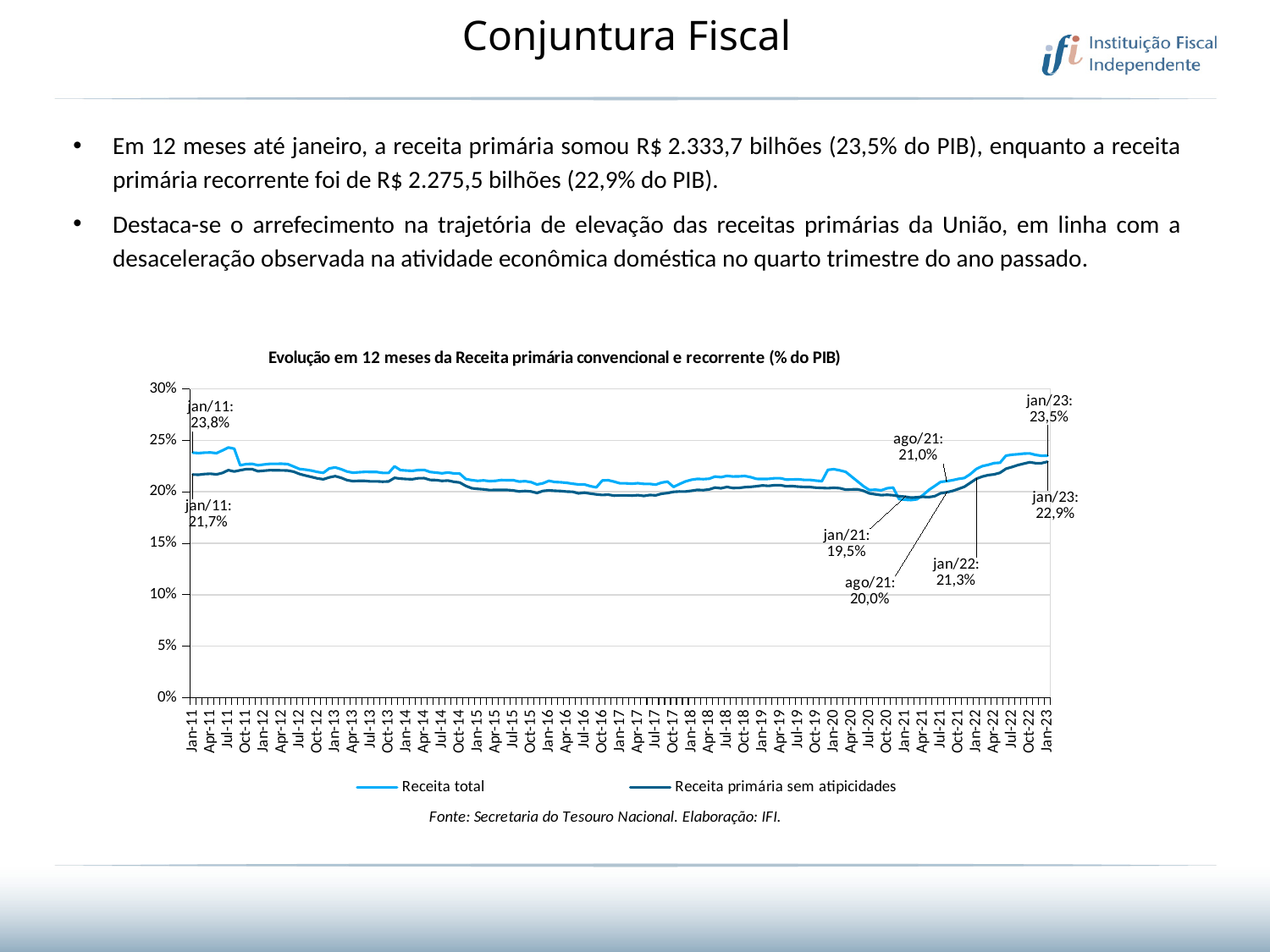
What value is labelled for jan/22 on the chart? 21,3% What is the labelled value of Receita primária sem atipicidades in jan/23? 22,9% In jan/11, which series has the higher value: Receita total or Receita primária sem atipicidades? Receita total What type of chart is shown on the slide? Line chart What is the labelled value of Receita primária sem atipicidades in jan/11? 21,7% What is the labelled value of Receita total in jan/23? 23,5% What is the labelled value of Receita total in jan/11? 23,8% Is the value of Receita total in Jan-16 greater or less than 25%? less What is the labelled value of Receita total in ago/21? 21,0% What is the difference between the two labelled values for jan/23 (23,5% and 22,9%)? 0,6 percentage points What is the title of the chart? Evolução em 12 meses da Receita primária convencional e recorrente (% do PIB) How many series does the chart legend list? 2